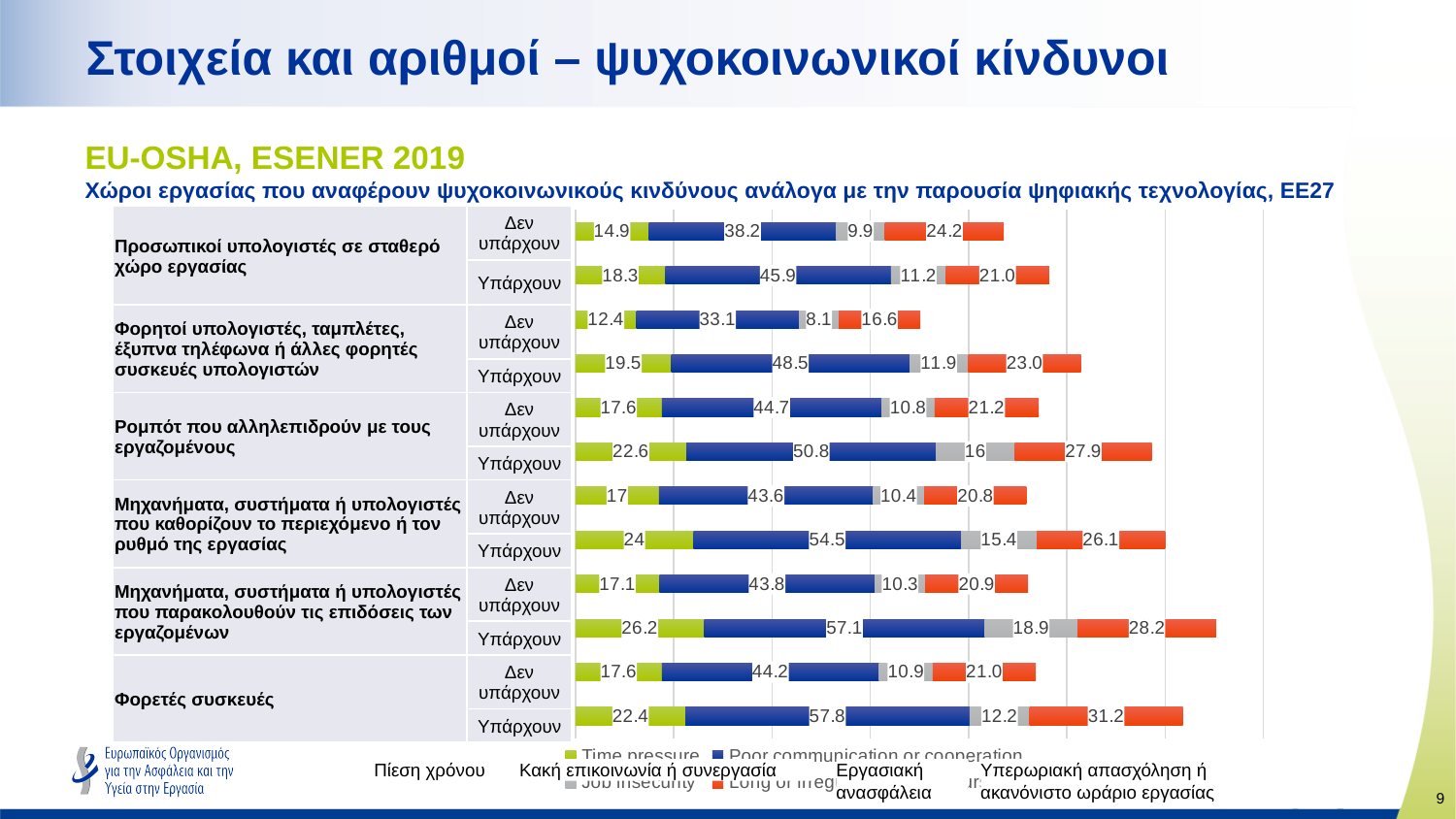
What is the total of the stacked bar for machines that determine the content or pace of work (Μηχανήματα... που καθορίζουν) when present (Υπάρχουν)? 120 What type of chart is shown on the slide? Stacked horizontal bar chart What is the value for Time pressure (Πίεση χρόνου) for wearable devices (Φορετές συσκευές) when they are present (Υπάρχουν)? 22.4 What is the value for Long or irregular working hours for portable computers, tablets, smartphones (Φορητοί υπολογιστές...) when not present (Δεν υπάρχουν)? 16.6 Which bar has the lowest Time pressure value? Φορητοί υπολογιστές, ταμπλέτες, έξυπνα τηλέφωνα ή άλλες φορητές συσκευές υπολογιστών – Δεν υπάρχουν (12.4) How many technology categories are listed on the chart? 6 How many series does the legend list? 4 Which bar has the highest Poor communication or cooperation value? Φορετές συσκευές – Υπάρχουν (57.8) Which is larger: the Long or irregular working hours value for personal computers at a fixed workplace when present (Υπάρχουν) or when not present (Δεν υπάρχουν)? Δεν υπάρχουν (24.2) What is the value for Job insecurity (Εργασιακή ανασφάλεια) for machines that monitor worker performance (Μηχανήματα... που παρακολουθούν τις επιδόσεις) when present (Υπάρχουν)? 18.9 What is the value for Poor communication or cooperation (Κακή επικοινωνία ή συνεργασία) for robots interacting with workers (Ρομπότ που αλληλεπιδρούν με τους εργαζομένους) when they are not present (Δεν υπάρχουν)? 44.7 What is the difference in Time pressure between Υπάρχουν and Δεν υπάρχουν for machines that monitor worker performance (26.2 vs 17.1)? 9.1